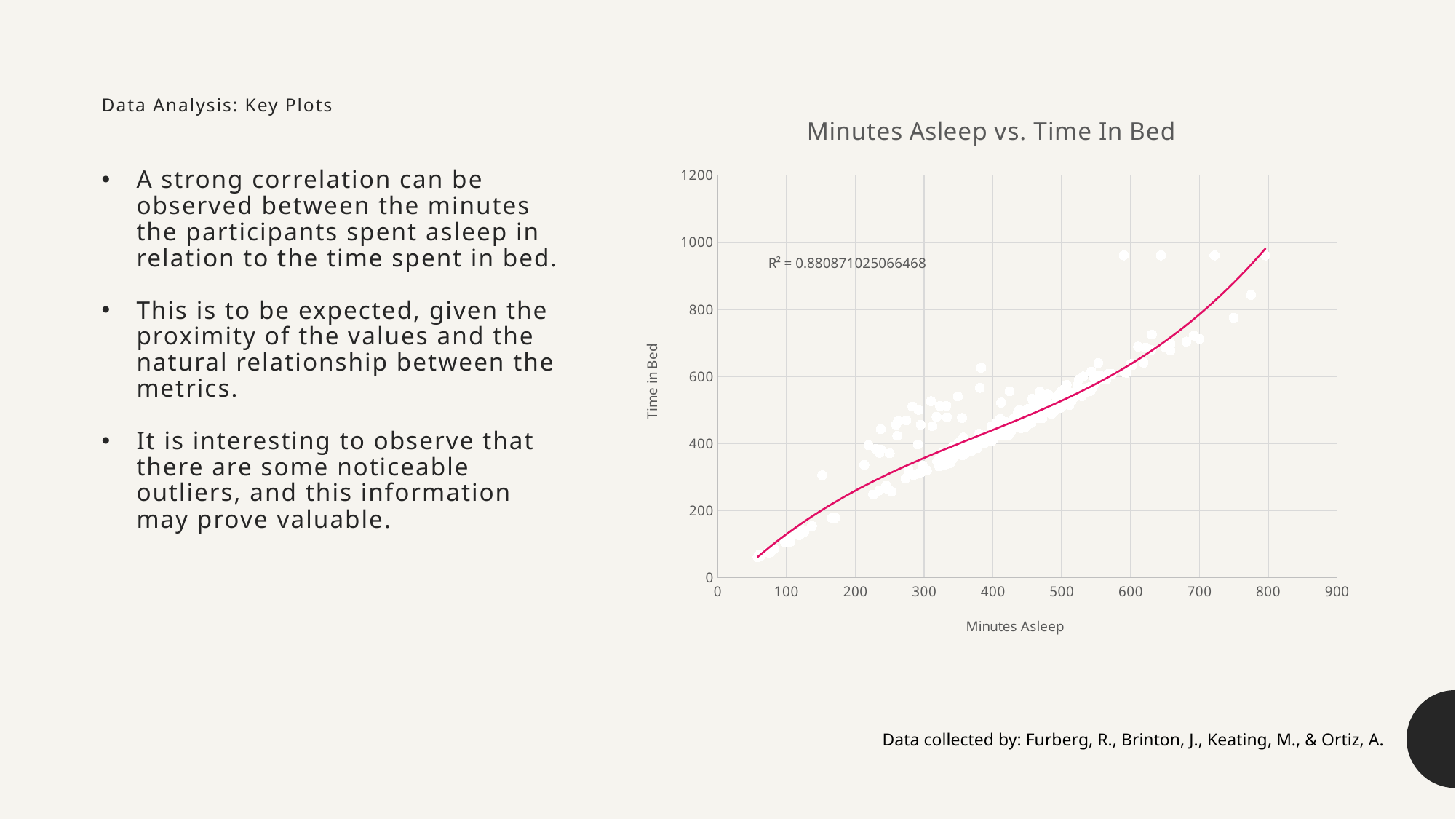
Is the Time in Bed value for the highest point near 600 Minutes Asleep greater or less than 800? greater What kind of chart is shown on the slide? scatter plot Is the Time in Bed value for the point at about 100 Minutes Asleep greater or less than 200? less Is the R² value printed on the chart greater or less than 0.8? greater What is the label of the x axis of the chart? Minutes Asleep What R² value is printed on the chart? 0.880871025066468 Do the Time in Bed values generally rise or fall as Minutes Asleep increases? rise What is the highest tick value shown on the x axis of the chart? 900 What is the highest tick value shown on the y axis of the chart? 1200 What is the title of the chart? Minutes Asleep vs. Time In Bed